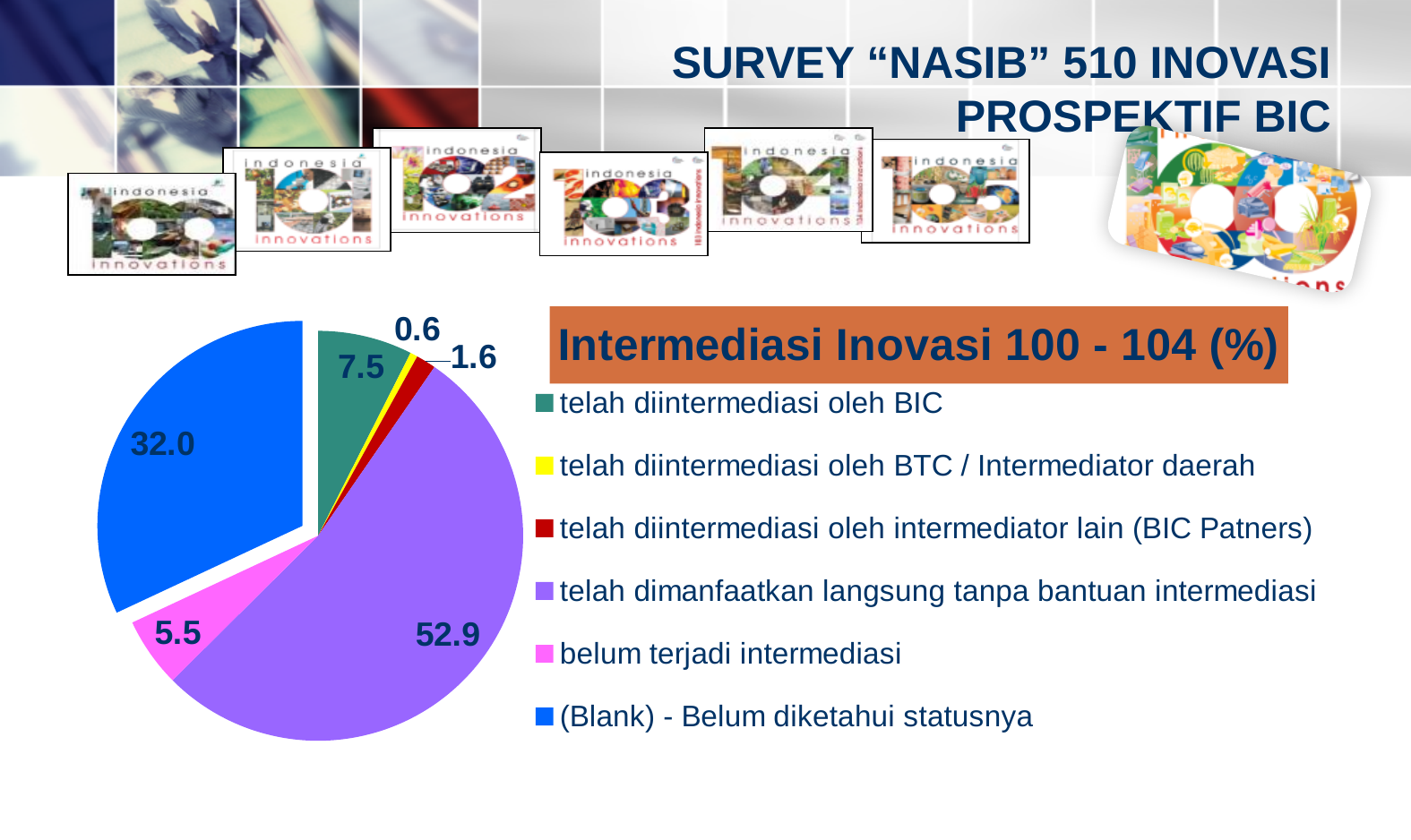
How many categories does the legend list? 6 Which is larger, the value for "telah diintermediasi oleh BIC" or the value for "belum terjadi intermediasi"? telah diintermediasi oleh BIC What is the value for "belum terjadi intermediasi"? 5.5 Which category has the largest slice of the pie? telah dimanfaatkan langsung tanpa bantuan intermediasi What is the value for "telah diintermediasi oleh BTC / Intermediator daerah"? 0.6 What is the value for "telah dimanfaatkan langsung tanpa bantuan intermediasi"? 52.9 What is the difference between the values for "telah dimanfaatkan langsung tanpa bantuan intermediasi" and "(Blank) - Belum diketahui statusnya"? 20.9 What is the value for "telah diintermediasi oleh BIC"? 7.5 What is the title of the chart? Intermediasi Inovasi 100 - 104 (%) What type of chart is shown on the slide? Pie chart Which category has the smallest slice of the pie? telah diintermediasi oleh BTC / Intermediator daerah What is the value for "(Blank) - Belum diketahui statusnya"? 32.0